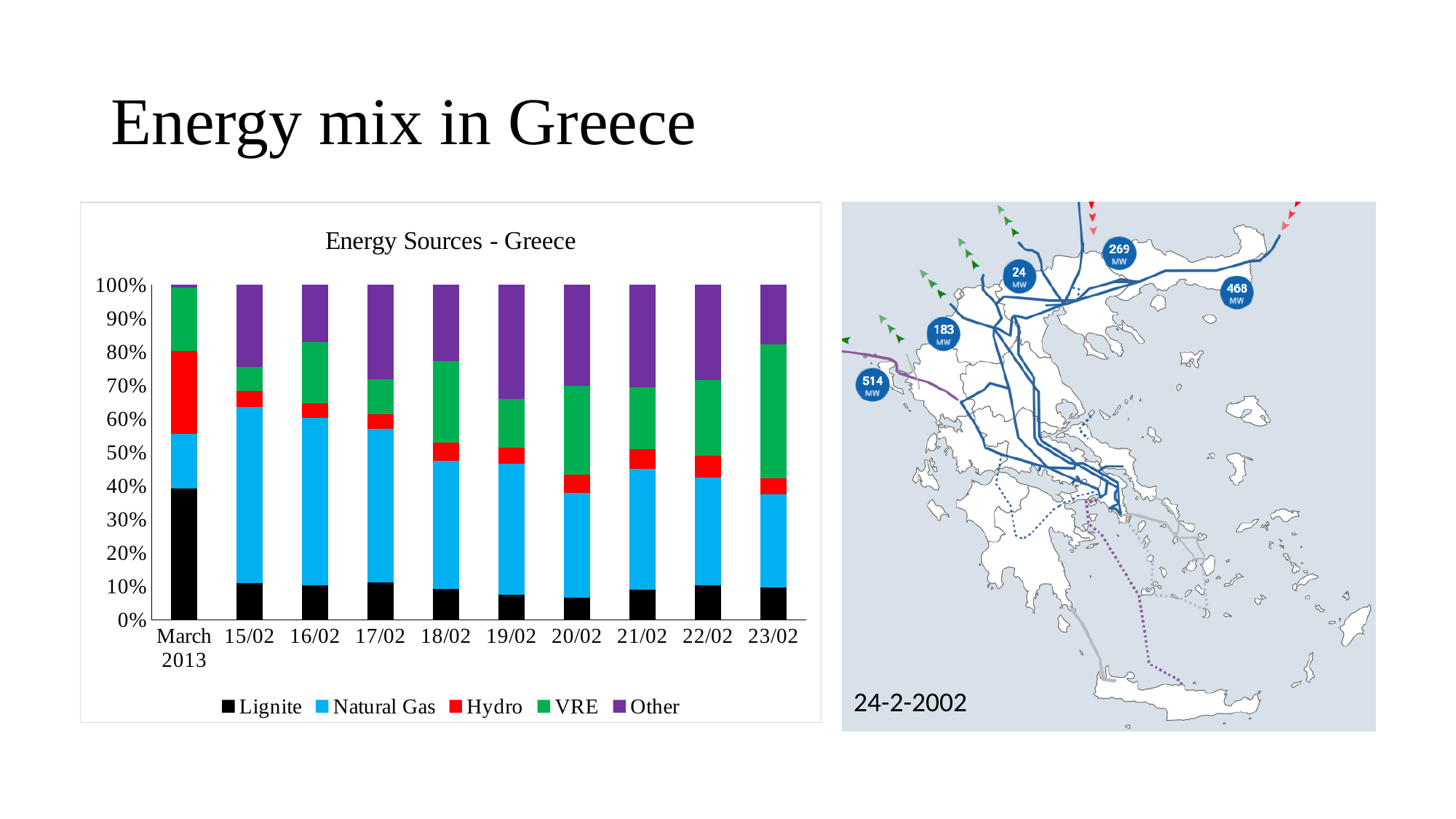
Which category has the highest share of VRE? 23/02 Which category has the highest share of Lignite? March 2013 What is the title of the chart? Energy Sources - Greece Which category has the highest share of Hydro? March 2013 Is the Lignite share for 15/02 greater or less than 20%? less Is the Lignite share for March 2013 greater or less than 30%? greater What kind of chart is shown on the slide? Stacked bar chart Does the Natural Gas share rise or fall from 15/02 to 20/02? Fall Which category has the lowest share of Other? March 2013 How many categories (bars) are shown along the x axis? 10 How many series does the chart's legend list? 5 Which has the larger Natural Gas share, 15/02 or 23/02? 15/02